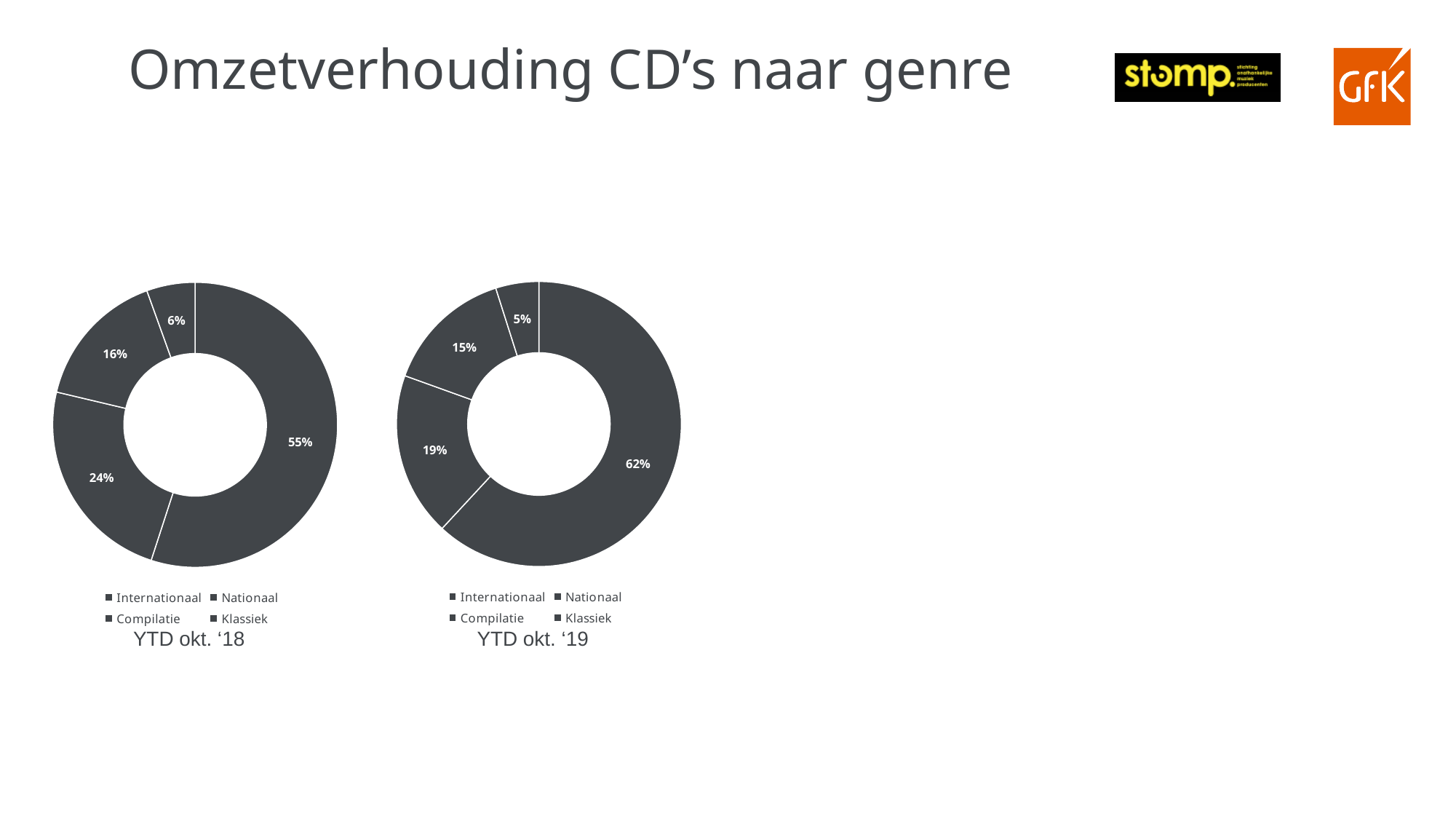
What is the difference between the largest slice in the YTD okt. '19 chart and the largest slice in the YTD okt. '18 chart? 7% How many entries does the legend of the YTD okt. '18 chart list? 4 In the YTD okt. '19 chart, what is the value of the largest slice? 62% In the YTD okt. '18 chart, what is the value of the smallest slice? 6% In the YTD okt. '18 chart, what is the value of the largest slice? 55% In the YTD okt. '19 chart, what is the value of the smallest slice? 5% What kind of chart is the YTD okt. '18 chart? Pie (donut) chart How many slices does the YTD okt. '19 chart have? 4 What is the title of the slide containing the two charts? Omzetverhouding CD's naar genre